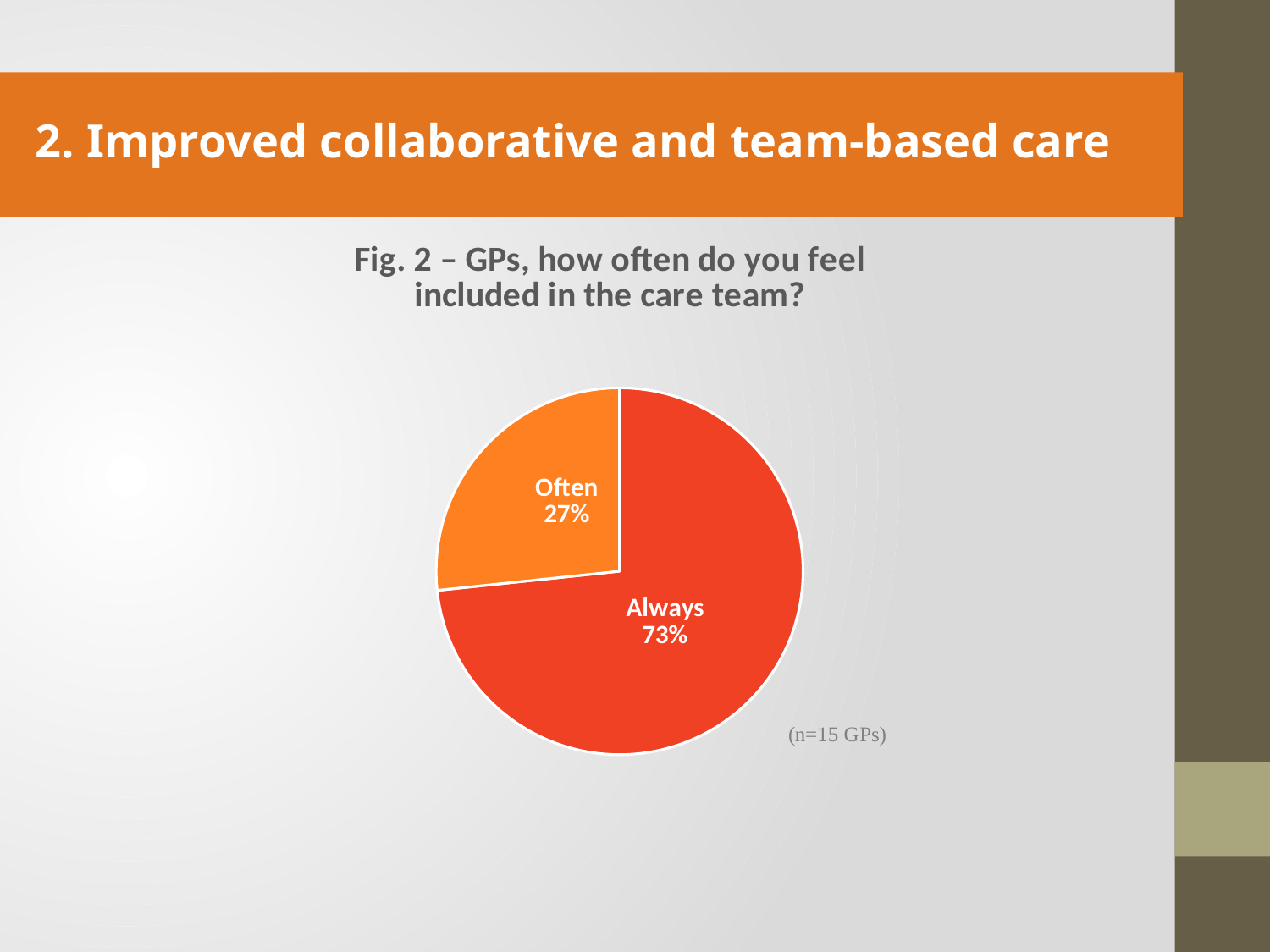
Which slice is larger, "Always" or "Often"? Always How many GPs responded to the survey shown in the chart? 15 What share of the pie does the "Always" slice represent? 73% What kind of chart is shown on the slide? pie chart Which response has the smallest share of the pie? Often What percentage of GPs answered "Always"? 73% What is the difference in percentage points between the "Always" and "Often" slices? 46 Which response has the largest share of the pie? Always What percentage of GPs answered "Often"? 27% How many slices does the pie chart have? 2 What is the title of the chart? Fig. 2 – GPs, how often do you feel included in the care team?